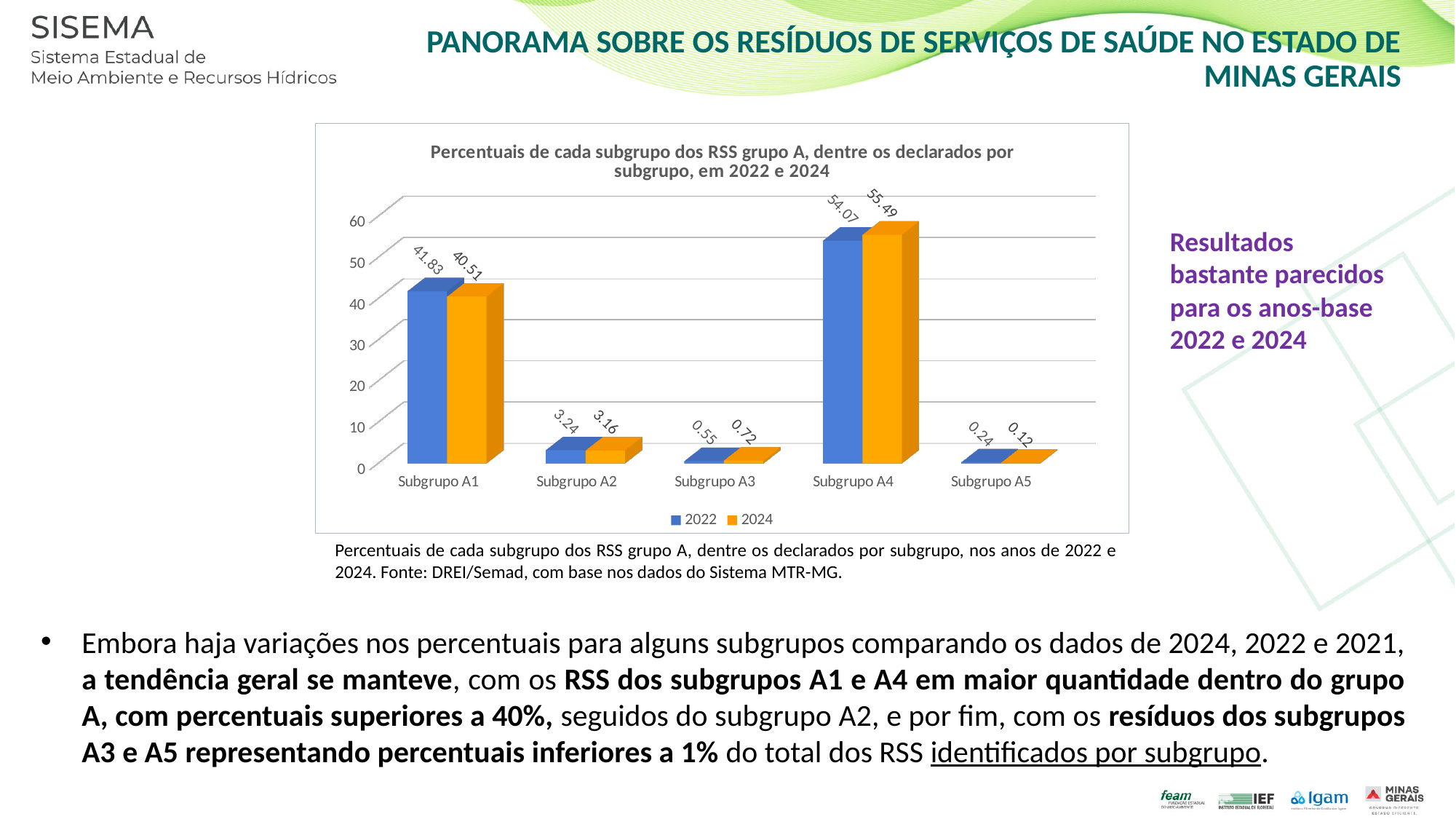
What is the difference between the 2024 and 2022 values for Subgrupo A4? 1.42 What kind of chart is shown on the slide? Bar chart Which is larger for Subgrupo A2: the 2022 value or the 2024 value? 2022 How many subgroups are shown on the x axis? 5 What is the value for Subgrupo A4 in the 2024 series? 55.49 Which subgroup has the highest value in the 2024 series? Subgrupo A4 Which subgroup has the lowest value in the 2022 series? Subgrupo A5 How many series does the legend list? 2 Is the 2022 value for Subgrupo A1 greater or less than 40? greater What is the value for Subgrupo A1 in the 2022 series? 41.83 What is the value for Subgrupo A5 in the 2022 series? 0.24 What is the value for Subgrupo A3 in the 2024 series? 0.72